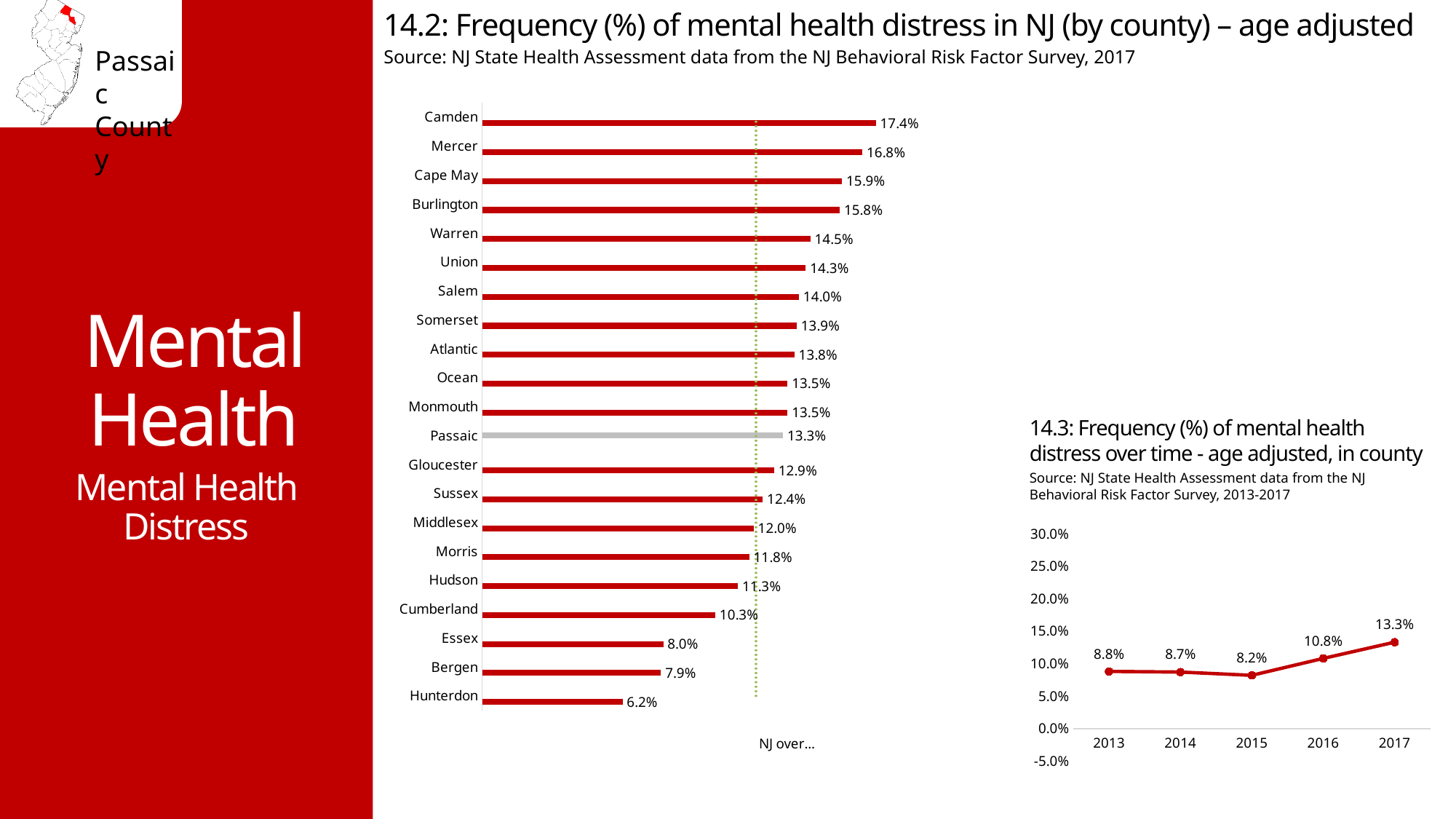
What kind of chart is chart 14.2 (frequency of mental health distress by county)? Bar chart In chart 14.3 (frequency of mental health distress over time), how many years are plotted? 5 In chart 14.2 (frequency of mental health distress by county), which county has the lowest value? Hunterdon In chart 14.3 (frequency of mental health distress over time), which year has the lowest value? 2015 In chart 14.2 (frequency of mental health distress by county), which is larger, the value for Mercer or the value for Cape May? Mercer In chart 14.3 (frequency of mental health distress over time), what is the difference between the 2017 and 2013 values? 4.5% In chart 14.2 (frequency of mental health distress by county), what is the difference between Camden and Hunterdon? 11.2% In chart 14.3 (frequency of mental health distress over time), what is the value for 2016? 10.8% In chart 14.2 (frequency of mental health distress by county), what is the value for Passaic? 13.3% In chart 14.2 (frequency of mental health distress by county), what is the value for Essex? 8.0% In chart 14.2 (frequency of mental health distress by county), how many counties are shown? 21 In chart 14.2 (frequency of mental health distress by county), which county has the highest value? Camden